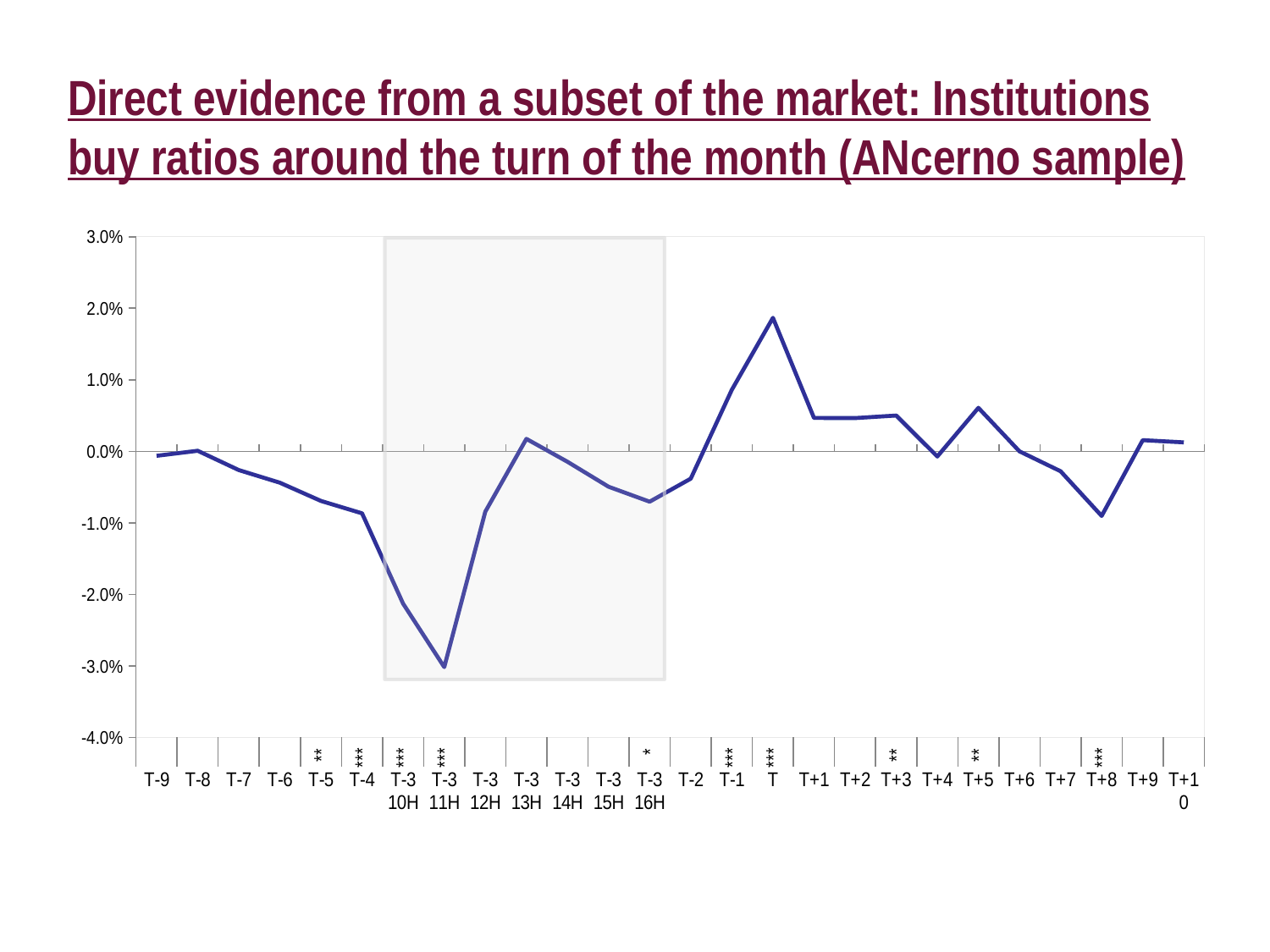
Do the values rise or fall from T-9 to T-3 11H? fall Is the value for T+8 greater or less than 0.0%? less Which category has the highest buy ratio? T Which sample is named in the chart's title? ANcerno sample Is the value for T-3 10H greater or less than -1.0%? less Which category has the lowest buy ratio? T-3 11H Is the value for T-3 11H greater or less than -2.0%? less Which is larger, the value for T or the value for T-1? T How many categories are shown on the x axis? 26 What kind of chart is shown on the slide? Line chart Which is larger, the value for T+5 or the value for T+4? T+5